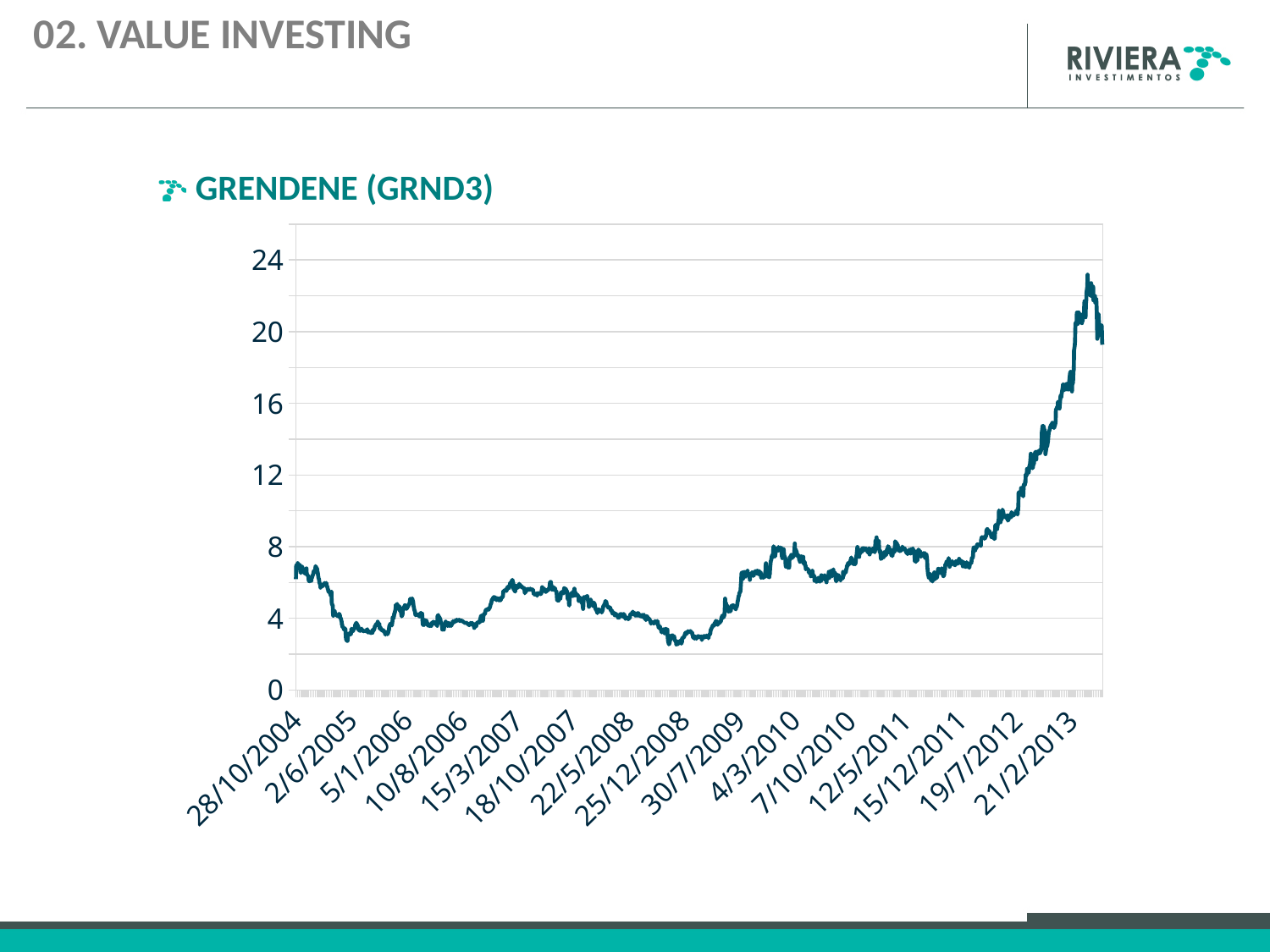
Does the line rise or fall between 15/12/2011 and 21/2/2013? rise Is the peak value of the line greater or less than 20? greater Is the value at 21/2/2013 greater or less than 16? greater Is the value at 19/7/2012 greater or less than 8? greater What is the title of the chart? GRENDENE (GRND3) What is the highest value shown on the y axis? 24 How many date labels are shown on the x axis? 15 What kind of chart is shown on the slide? line chart Overall, does the line rise or fall from 28/10/2004 to 21/2/2013? rise